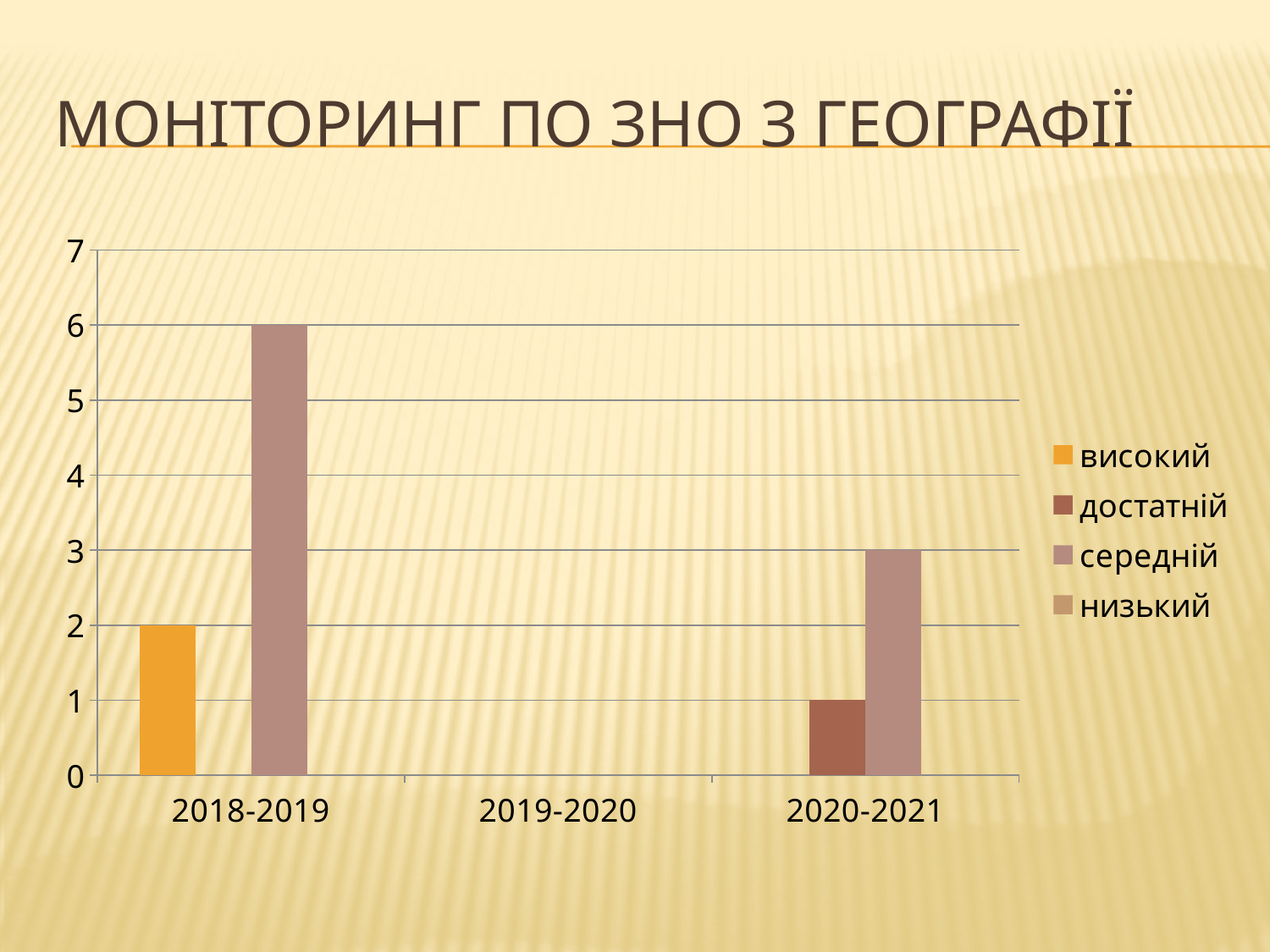
Which is larger: високий in 2018-2019 or достатній in 2020-2021? високий in 2018-2019 What is the value for високий in 2018-2019? 2 Does the середній value for 2018-2019 rise or fall by 2020-2021? fall How many series does the legend list? 4 What is the value for середній in 2018-2019? 6 What kind of chart is shown on the slide? bar chart What is the difference between the середній values for 2018-2019 and 2020-2021? 3 Which category has the tallest bar in the chart? 2018-2019 What is the value for достатній in 2020-2021? 1 How many categories are shown on the x axis? 3 What is the title of the chart on the slide? МОНІТОРИНГ ПО ЗНО З ГЕОГРАФІЇ What is the value for середній in 2020-2021? 3